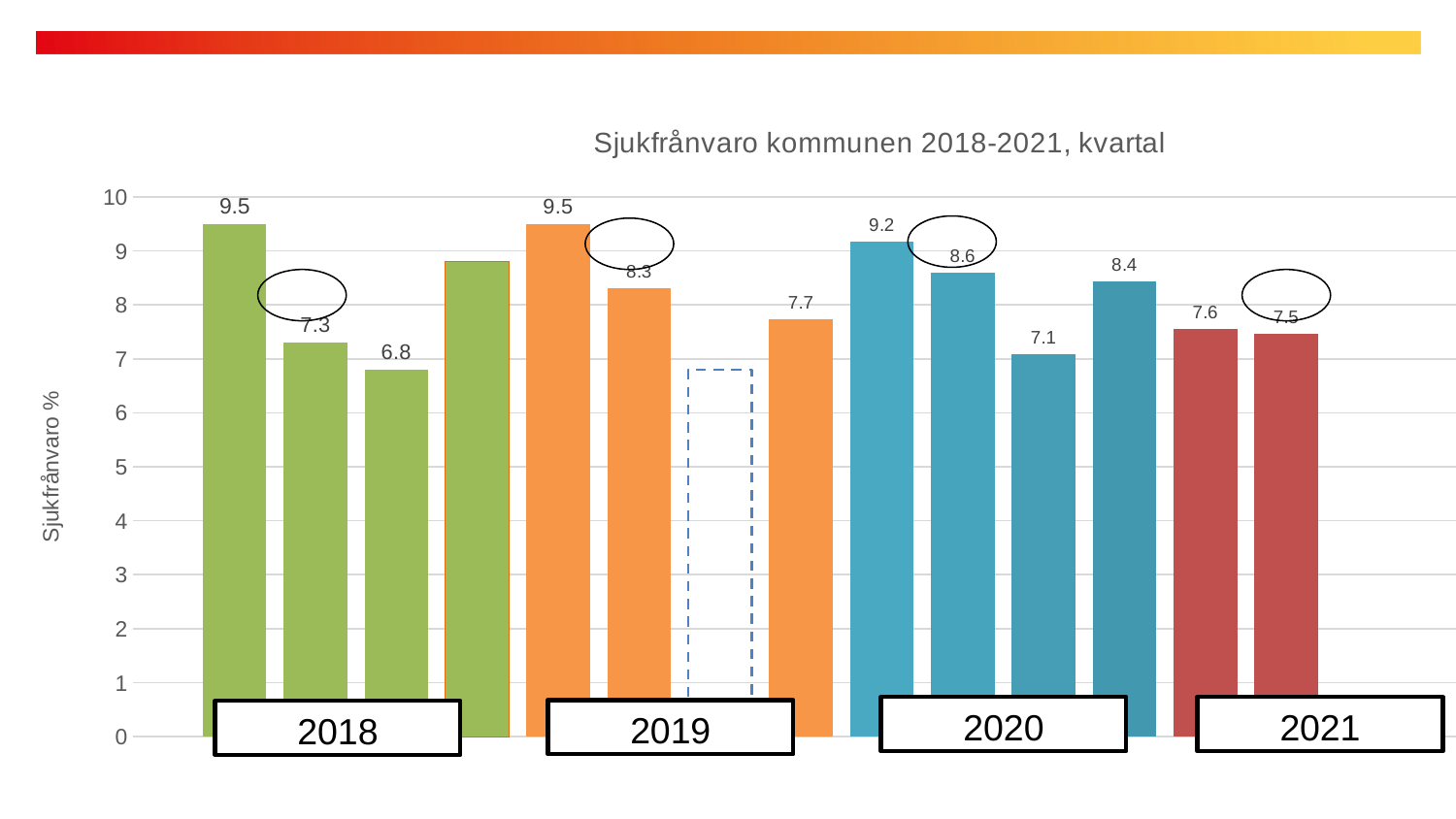
What is the difference between the first bar (9.5) and the third bar (6.8) in the 2018 group? 2.7 What is the value of the third bar in the 2020 group? 7.1 What is the title of the chart? Sjukfrånvaro kommunen 2018-2021, kvartal How many bars are shown in the 2021 group? 2 What is the lowest labelled value in the chart? 6.8 What is the value of the first bar in the 2018 group? 9.5 What type of chart is shown on the slide? bar chart Which is larger: the second bar of 2019 or the second bar of 2020? the second bar of 2020 (8.6) What is the label on the vertical axis? Sjukfrånvaro % What is the value of the second bar in the 2021 group? 7.5 Is the value of the fourth bar in the 2018 group greater or less than 8? greater Which bar in the 2020 group has the lowest value? the third bar (7.1)